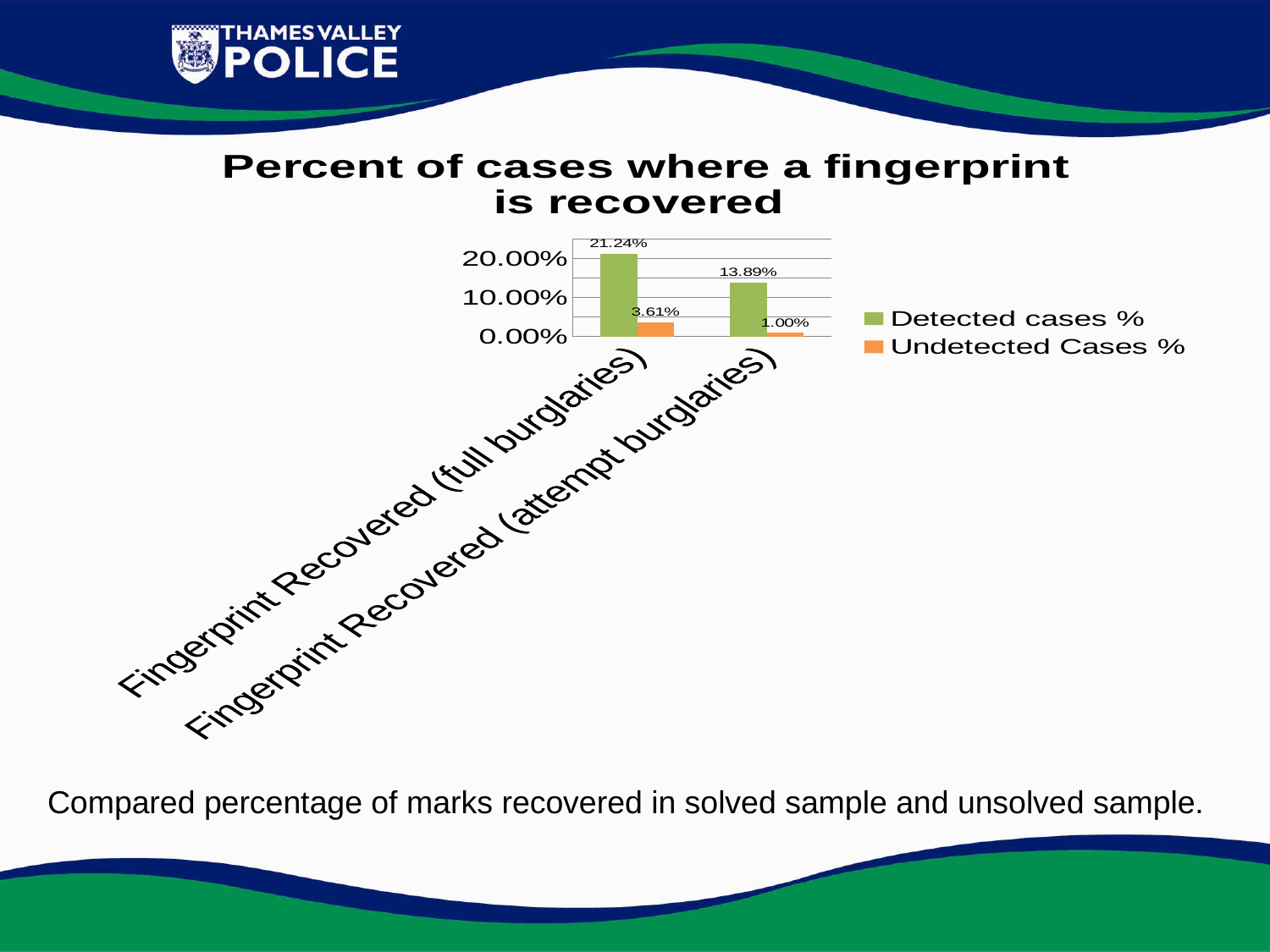
What is the Detected cases % value for Fingerprint Recovered (attempt burglaries)? 13.89% What kind of chart is shown on the slide? Bar chart Is the Detected cases % value for Fingerprint Recovered (attempt burglaries) greater or less than 10.00%? greater How many series does the legend list? 2 What is the Undetected Cases % value for Fingerprint Recovered (full burglaries)? 3.61% What is the difference between the Detected cases % and Undetected Cases % values for Fingerprint Recovered (full burglaries)? 17.63% Which category has the lowest Undetected Cases % value? Fingerprint Recovered (attempt burglaries) What is the Undetected Cases % value for Fingerprint Recovered (attempt burglaries)? 1.00% Which category has the highest Detected cases % value? Fingerprint Recovered (full burglaries) Which is larger: the Detected cases % for full burglaries or the Detected cases % for attempt burglaries? Detected cases % for full burglaries What is the Detected cases % value for Fingerprint Recovered (full burglaries)? 21.24% How many categories are shown on the x axis? 2